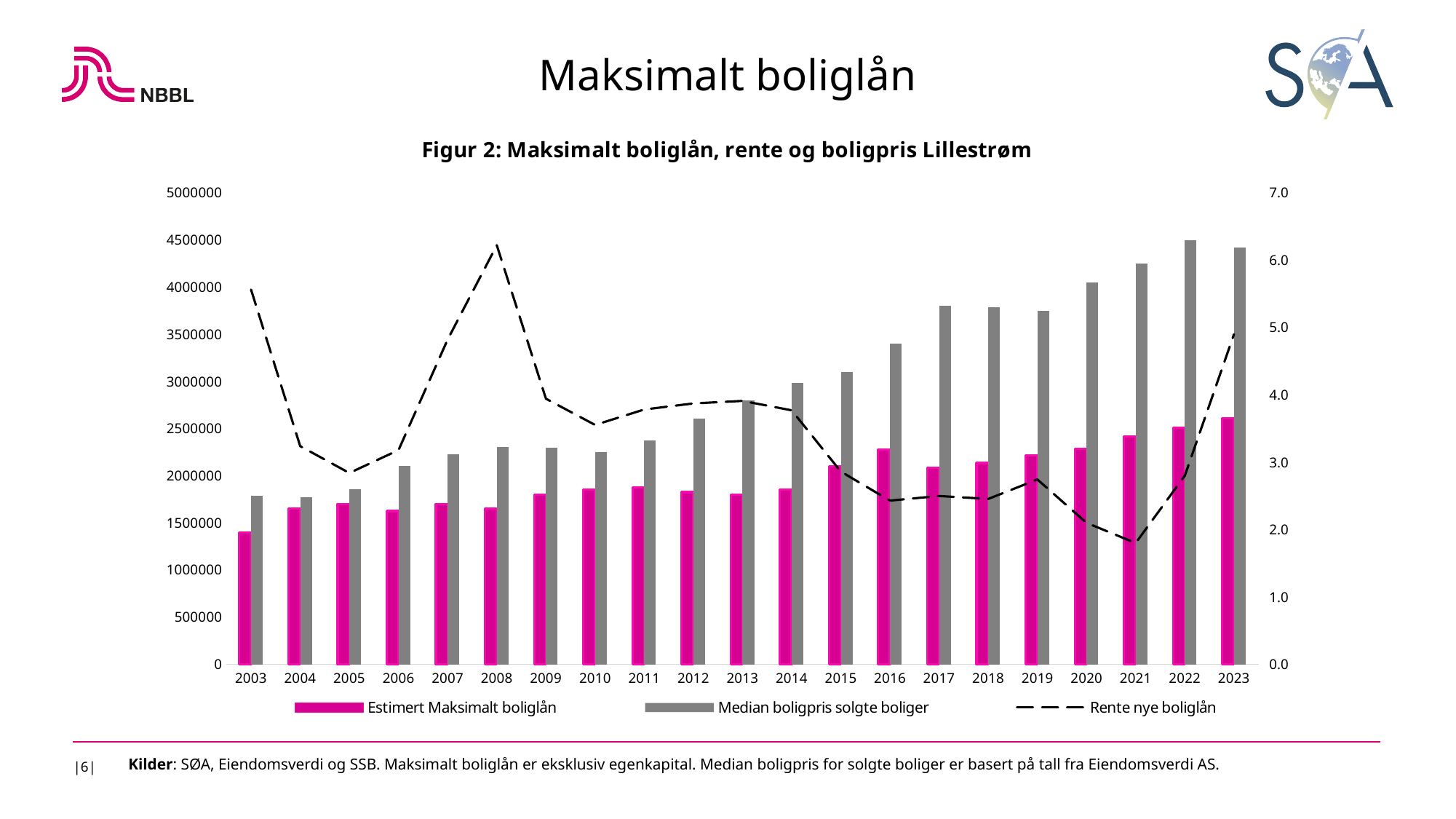
Is the value for Rente nye boliglån in 2008 greater or less than 6.0? greater In which year does Rente nye boliglån reach its lowest point? 2021 How many series does the legend list? 3 How many years are shown on the x axis? 21 Which is larger in 2013: Estimert Maksimalt boliglån or Median boligpris solgte boliger? Median boligpris solgte boliger Do the Median boligpris solgte boliger bars generally rise or fall from 2003 to 2023? Rise In which year does Rente nye boliglån reach its highest point? 2008 Which year has the lowest value for Estimert Maksimalt boliglån? 2003 What kind of chart is shown on the slide? Combined bar and line chart Which year has the highest value for Median boligpris solgte boliger? 2022 Which year has the highest value for Estimert Maksimalt boliglån? 2023